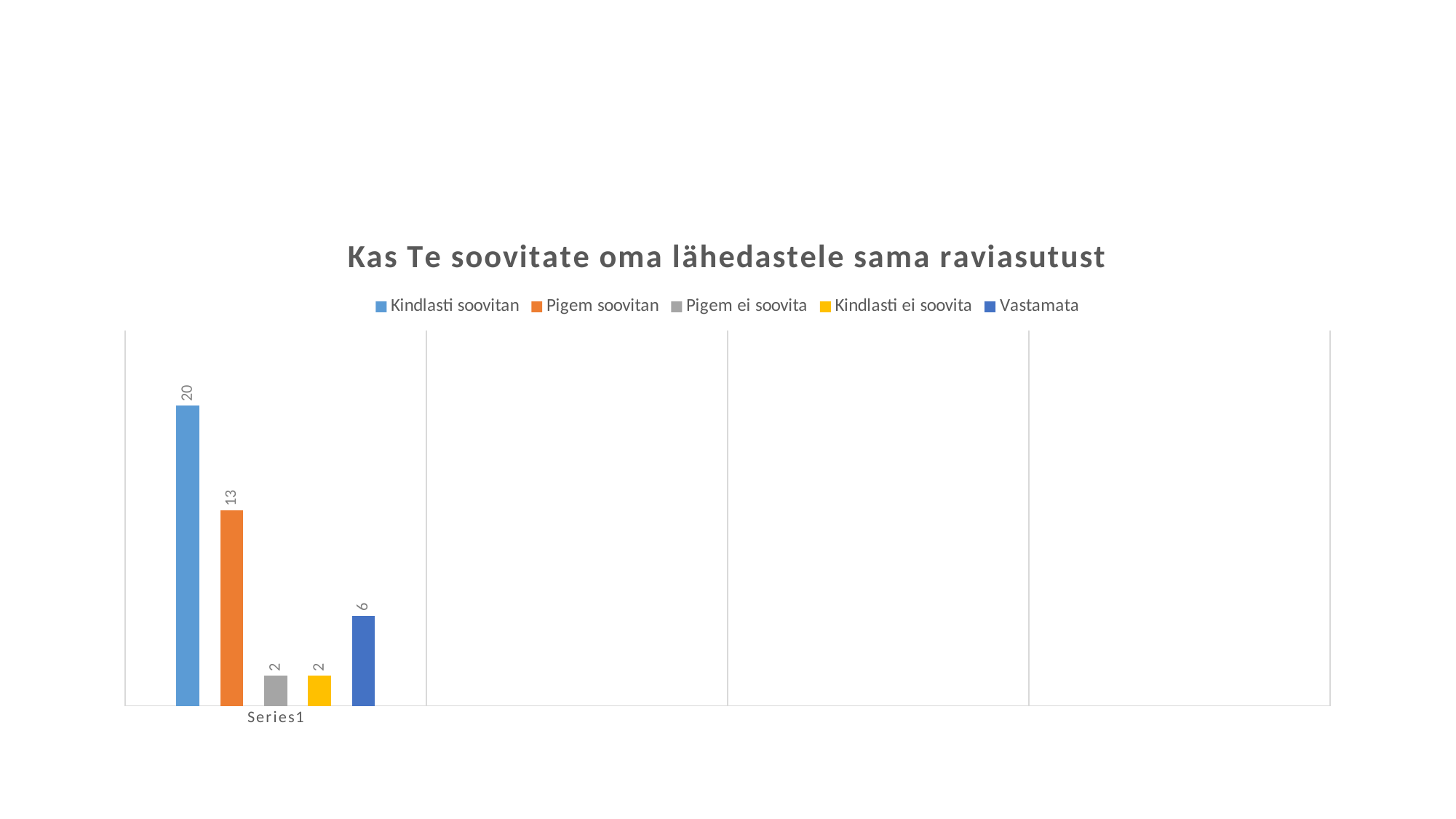
What kind of chart is shown? Bar chart What is the value for Vastamata? 6 What is the difference between Kindlasti soovitan and Pigem soovitan? 7 Which series has the highest value? Kindlasti soovitan What is the value for Pigem soovitan? 13 What colour is the bar for Kindlasti ei soovita? Yellow What is the difference between Pigem soovitan and Vastamata? 7 What is the value for Pigem ei soovita? 2 How many series does the legend list? 5 What is the value for Kindlasti soovitan? 20 What is the title of the chart? Kas Te soovitate oma lähedastele sama raviasutust Which is larger, Vastamata or Pigem ei soovita? Vastamata